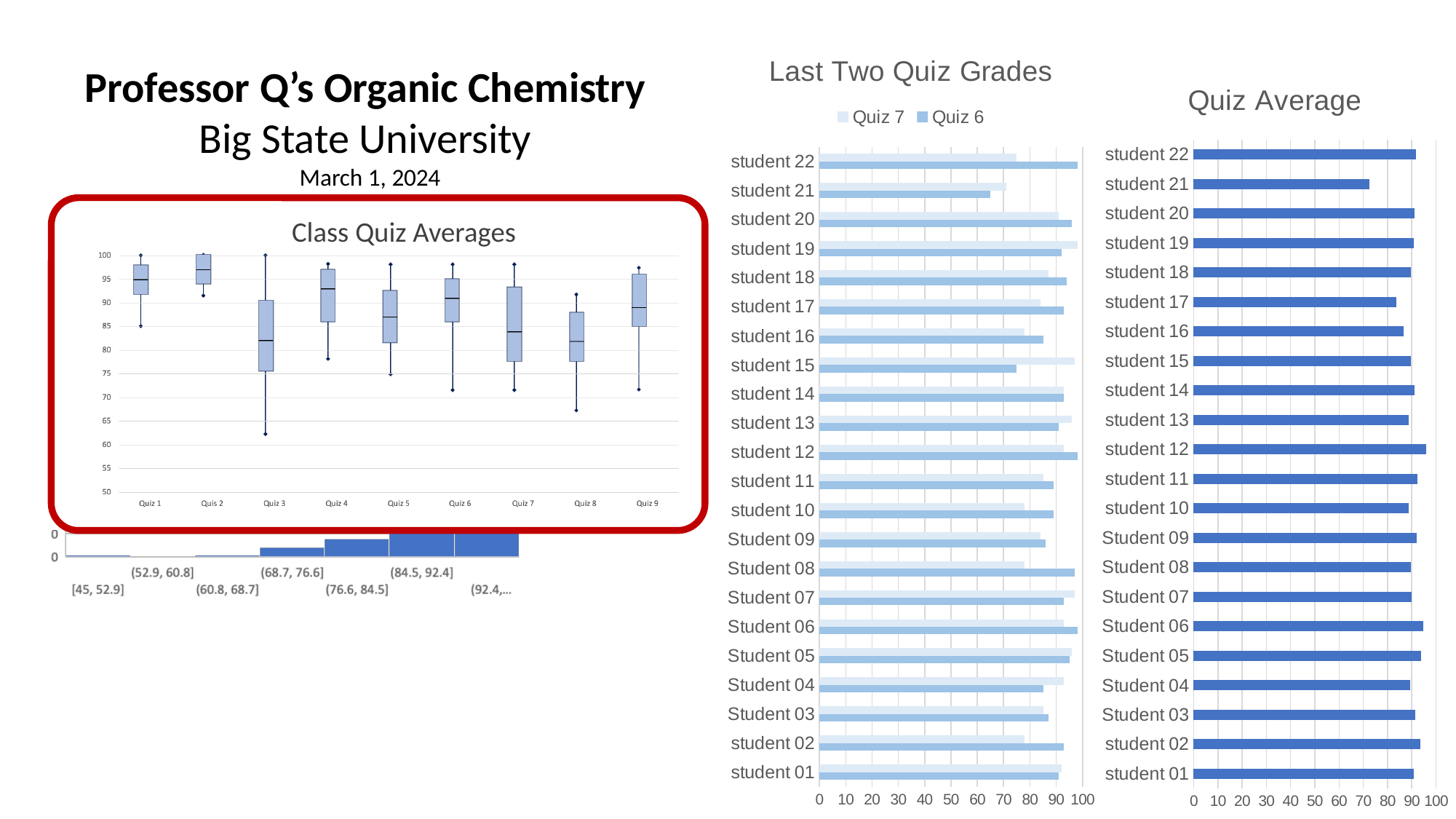
In the "Last Two Quiz Grades" chart, which is larger for student 22, the Quiz 7 grade or the Quiz 6 grade? Quiz 6 In the "Quiz Average" chart, is the value for student 12 greater or less than 90? greater How many quizzes are shown on the x axis of the "Class Quiz Averages" chart? 9 What are the legend entries of the "Last Two Quiz Grades" chart? Quiz 7 and Quiz 6 What kind of chart is the "Class Quiz Averages" chart inside the red box? box plot How many students are shown in the "Quiz Average" chart? 22 How many series does the legend of the "Last Two Quiz Grades" chart list? 2 In the "Quiz Average" chart, is the value for student 21 greater or less than 80? less In the "Quiz Average" chart, which student has the lowest average? student 21 In the "Last Two Quiz Grades" chart, which is larger for student 15, the Quiz 7 grade or the Quiz 6 grade? Quiz 7 In the "Class Quiz Averages" chart, is the median for Quiz 3 greater or less than 85? less What kind of chart is the "Last Two Quiz Grades" chart? bar chart